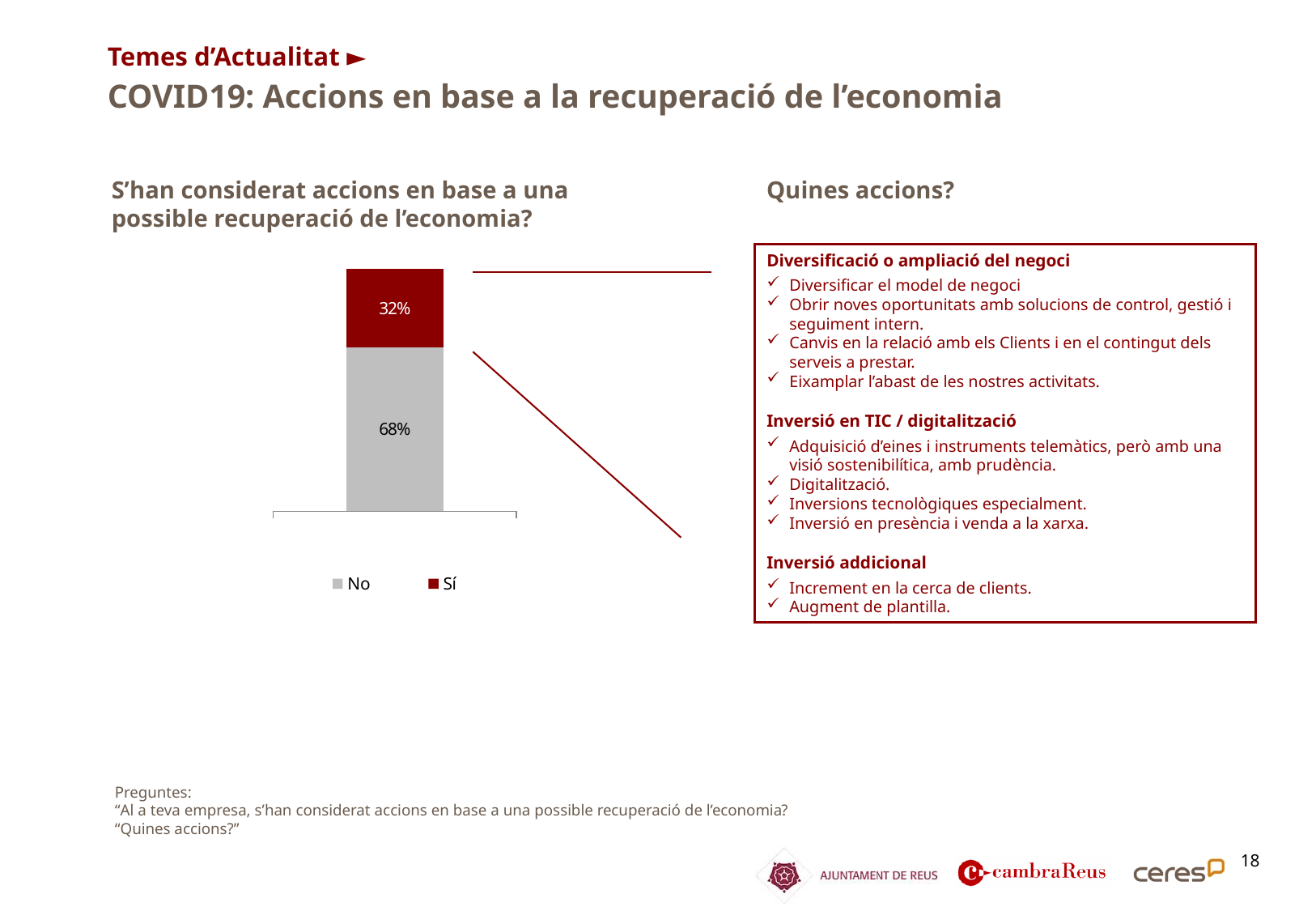
What kind of chart is shown on the slide? Stacked bar chart How many series does the chart legend list? 2 What is the total of the two segments in the stacked bar? 100% Which legend entry has the smallest value in the chart? Sí Which colour represents the "No" series in the chart? Grey What is the difference in percentage points between the "No" and "Sí" segments? 36 Which legend entry has the largest value in the chart? No What percentage of respondents answered "Sí" in the stacked bar chart? 32% How many bars are plotted in the chart? 1 What percentage of respondents answered "No" in the stacked bar chart? 68% Which colour represents the "Sí" series in the chart? Dark red Which response has the larger share in the stacked bar chart, "No" or "Sí"? No